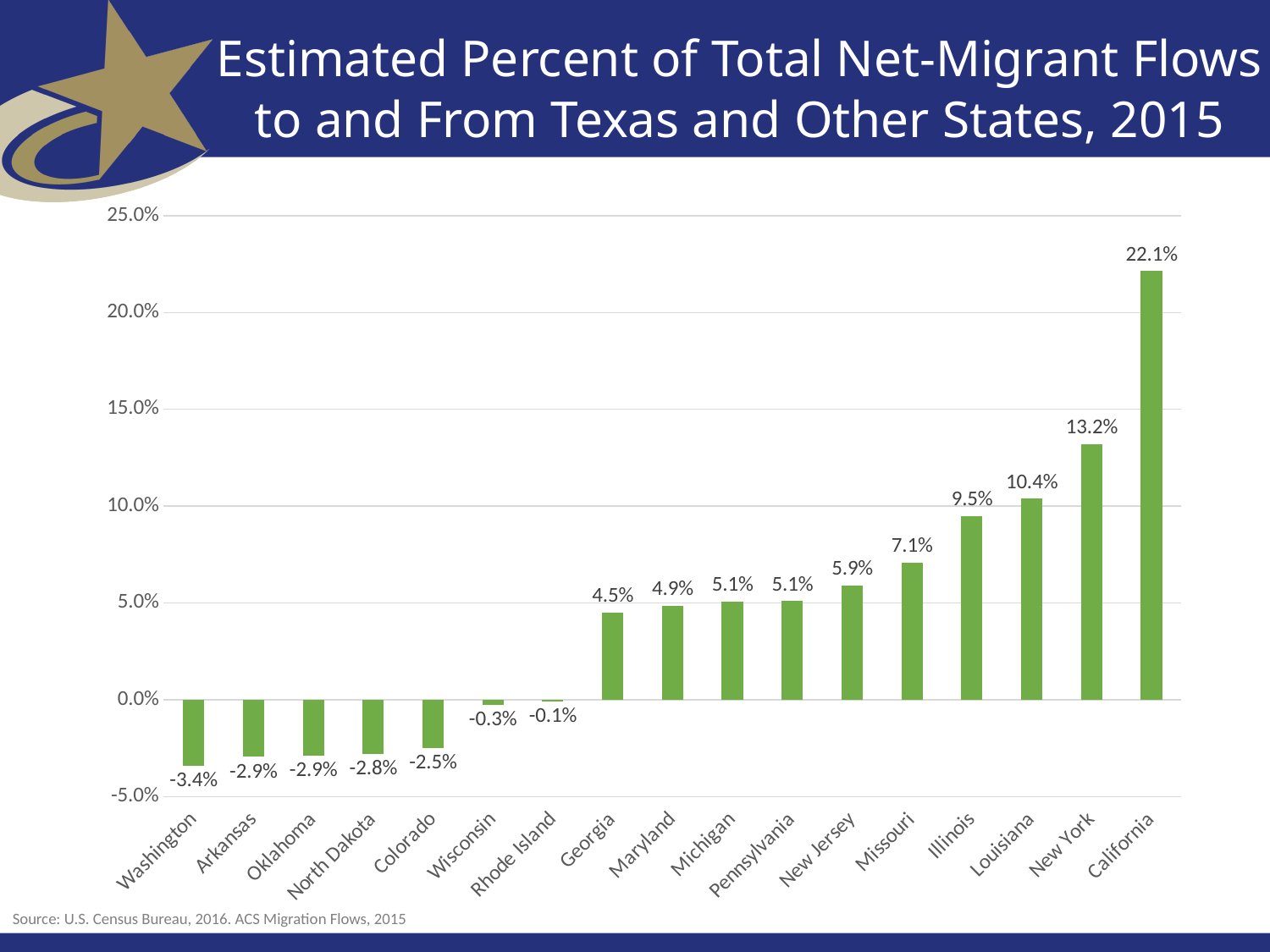
How many states are shown on the chart? 17 What is the title of the chart? Estimated Percent of Total Net-Migrant Flows to and From Texas and Other States, 2015 Is the value for New York greater or less than 10.0%? greater What is the value for Washington? -3.4% Which is larger, the value for Illinois or the value for Louisiana? Louisiana What is the difference between the values for California and New York? 8.9% What is the value for California? 22.1% Do the values rise or fall from left to right along the x axis? Rise What is the value for Missouri? 7.1% Which state has the highest value? California Which state has the lowest value? Washington What kind of chart is this? Bar chart